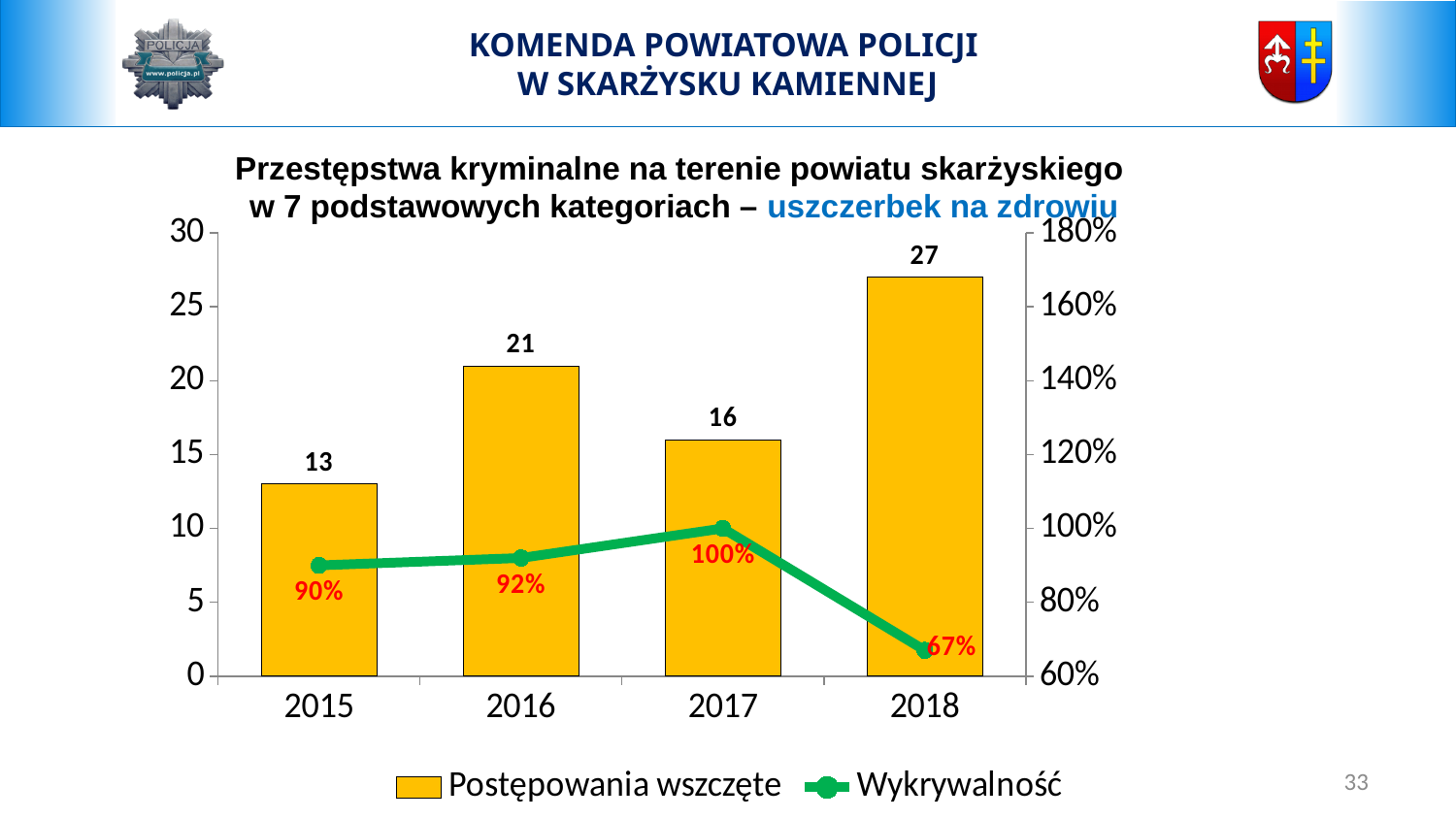
What kind of chart is shown on the slide? Combined bar and line chart Is the Wykrywalność value for 2018 greater or less than 80%? less What is the value of Postępowania wszczęte for 2015? 13 How many series does the legend list? 2 Which year has the highest value of Postępowania wszczęte? 2018 What is the difference between Postępowania wszczęte in 2018 and 2017? 11 Which year has the lowest Wykrywalność? 2018 What is the value of Postępowania wszczęte for 2018? 27 Which is larger, Postępowania wszczęte in 2016 or in 2017? 2016 How many years are shown on the x axis? 4 Does the Wykrywalność line rise or fall from 2017 to 2018? fall What is the Wykrywalność value for 2017? 100%